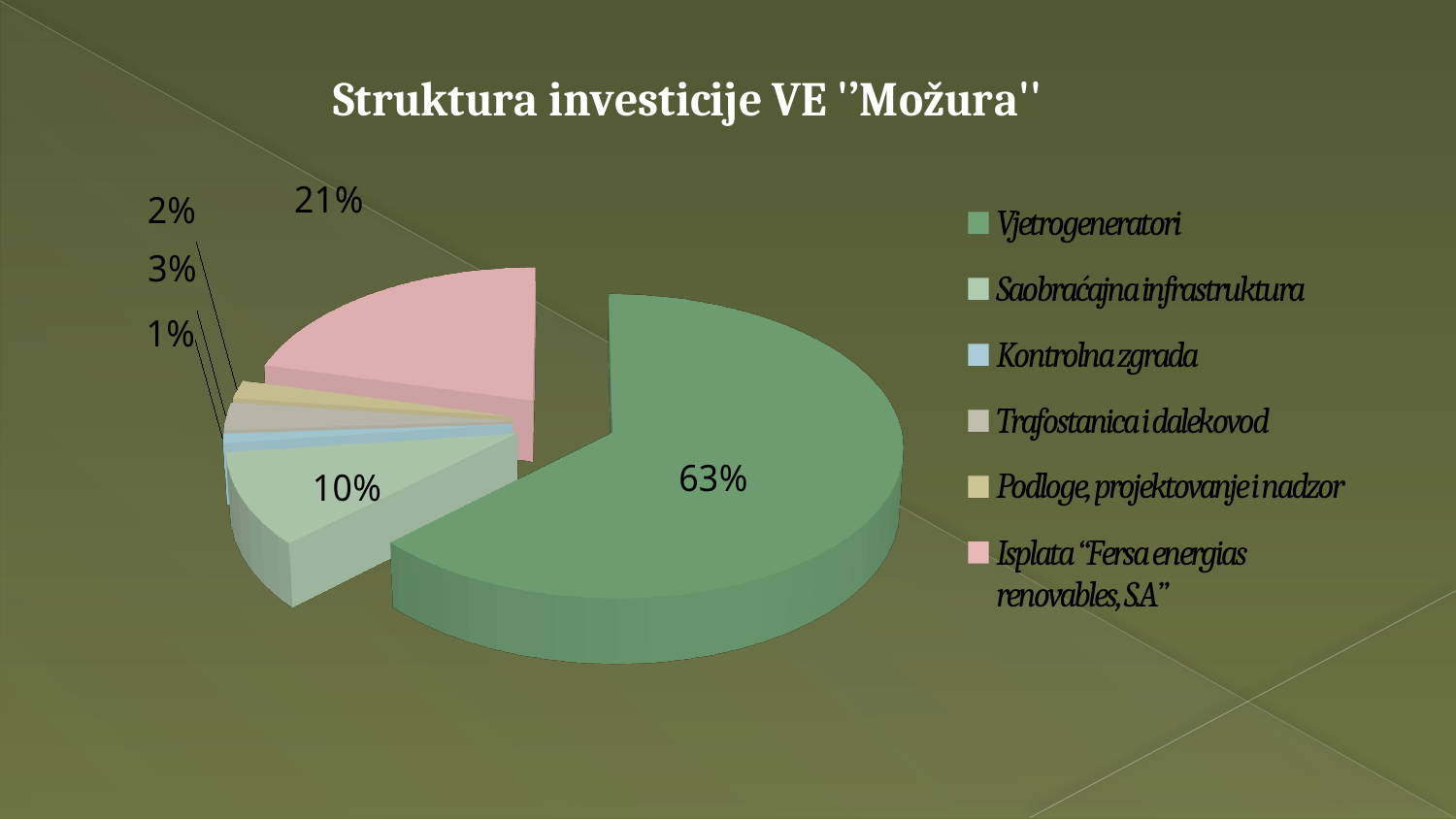
What is the smallest percentage shown on the pie chart? 1% What share of the investment is Isplata "Fersa energias renovables, SA"? 21% What is the title of the chart? Struktura investicije VE ''Možura'' What share of the investment is Vjetrogeneratori? 63% What colour is the Vjetrogeneratori slice? green What share of the investment is Saobraćajna infrastruktura? 10% Which category has the largest share of the pie? Vjetrogeneratori Which is larger: the share for Saobraćajna infrastruktura or the share for Isplata "Fersa energias renovables, SA"? Isplata "Fersa energias renovables, SA" How many categories does the legend list? 6 What is the combined share of Vjetrogeneratori and Saobraćajna infrastruktura? 73% How many percentage points larger is the Vjetrogeneratori share than the Isplata "Fersa energias renovables, SA" share? 42 percentage points What kind of chart is shown on the slide? pie chart